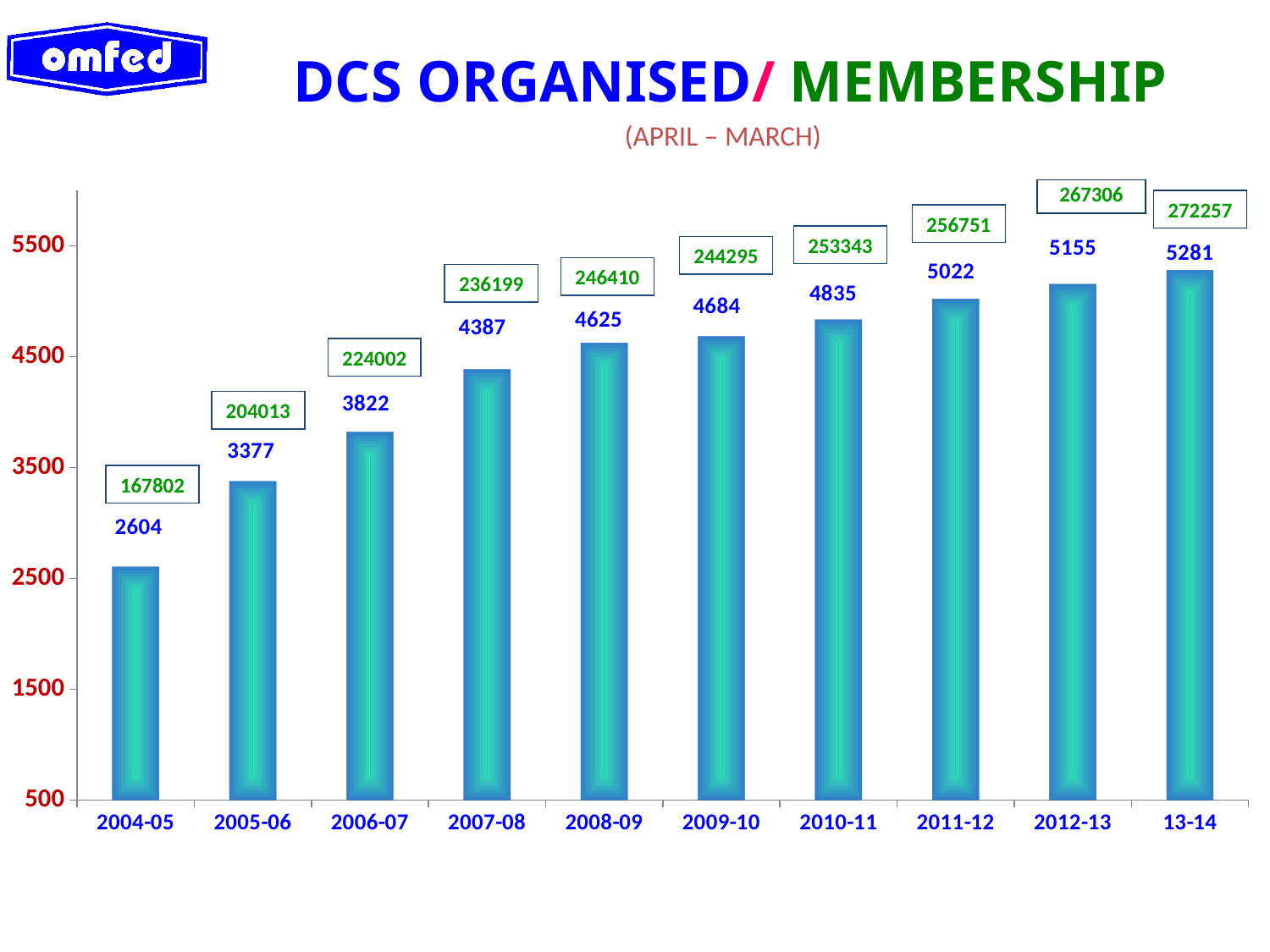
What is the number of DCS organised in 2004-05? 2604 What is the difference in membership between 13-14 and 2012-13? 4951 Is the number of DCS organised in 2006-07 greater or less than 3500? greater Which year has the highest number of DCS organised? 13-14 Which year has the larger membership figure, 2008-09 or 2009-10? 2008-09 What is the membership figure shown for 2010-11? 253343 What is the difference in DCS organised between 13-14 and 2004-05? 2677 Do the DCS organised values rise or fall from 2004-05 to 13-14? rise What type of chart is shown on the slide? bar chart What is the number of DCS organised in 2007-08? 4387 Which year has the lowest membership figure? 2004-05 How many years are shown on the x axis of the chart? 10